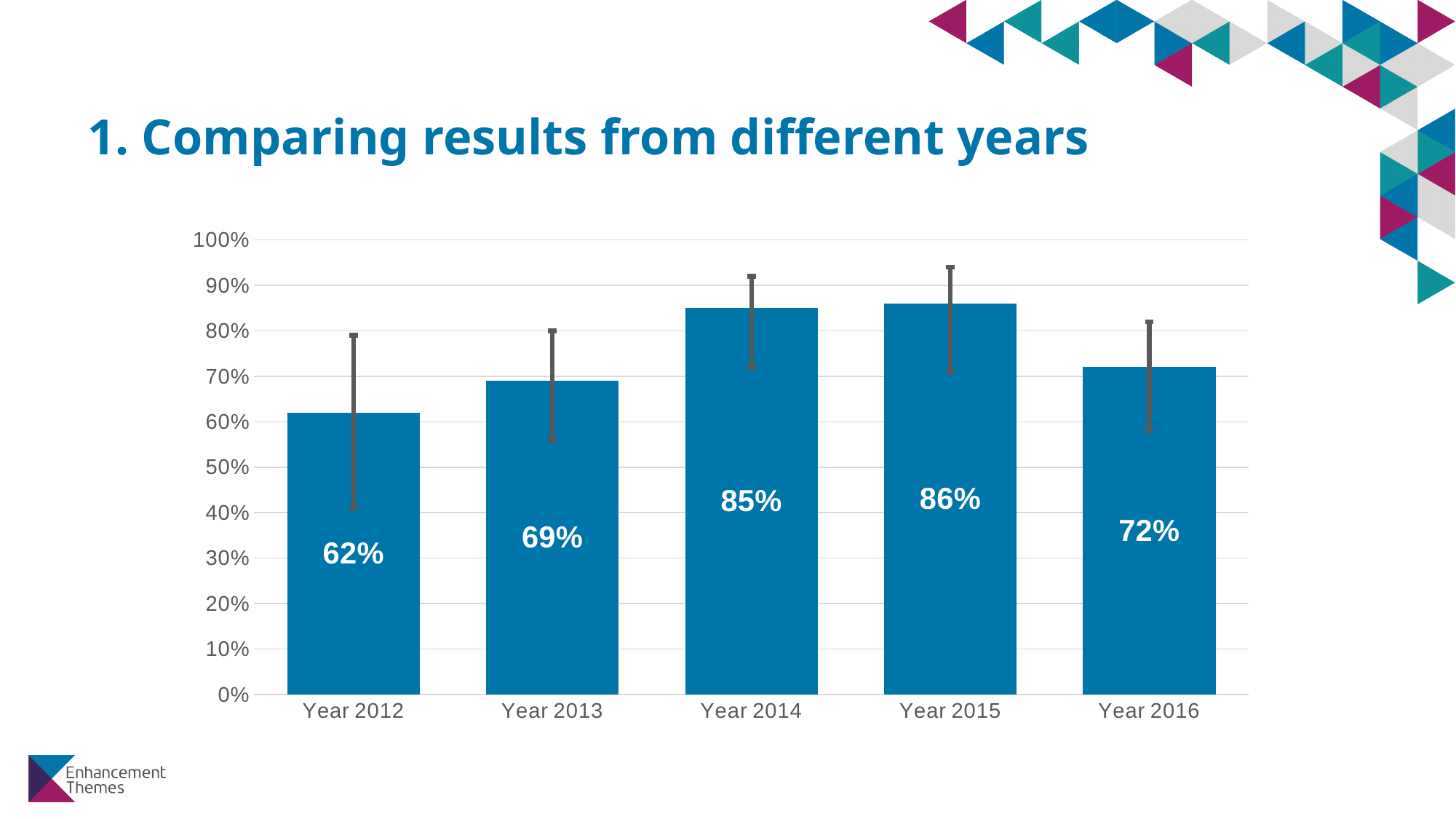
What is the value for Year 2016? 72% Which is larger, the value for Year 2013 or the value for Year 2016? Year 2016 What is the title of the slide? 1. Comparing results from different years Which year has the highest value? Year 2015 What is the difference between the values for Year 2013 and Year 2016? 3% What kind of chart is shown on the slide? Bar chart Which year has the lowest value? Year 2012 How many years are shown on the chart? 5 What is the value for Year 2012? 62% What is the value for Year 2014? 85% Is the value for Year 2015 greater or less than 80%? greater What is the difference between the values for Year 2014 and Year 2012? 23%